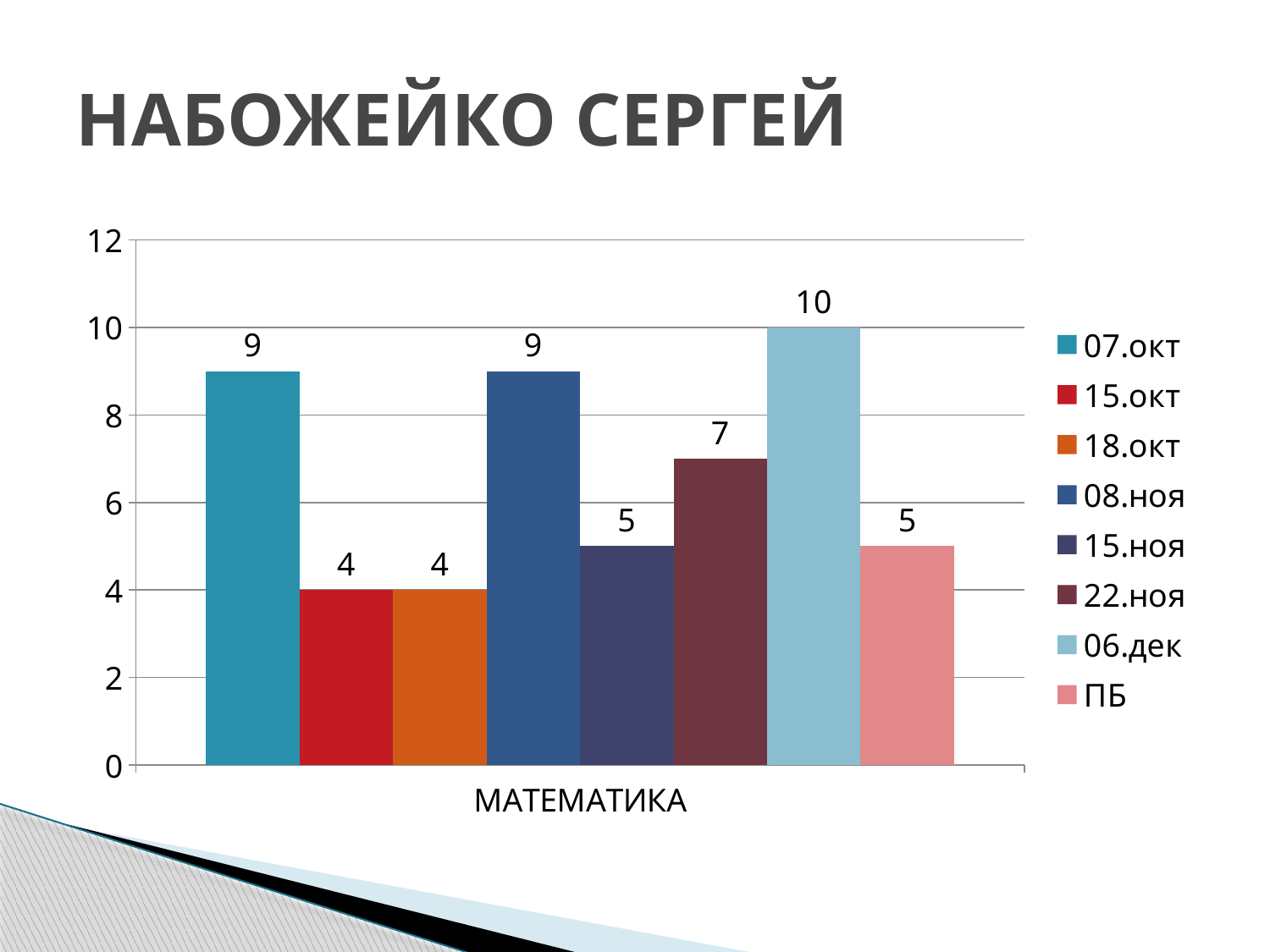
What is the difference between the 06.дек value and the 15.окт value? 6 What is the title of the slide? НАБОЖЕЙКО СЕРГЕЙ Which is larger, the value for 08.ноя or the value for 15.ноя? 08.ноя How many series does the legend list? 8 What is the value for the 22.ноя series? 7 Is the value for 22.ноя greater or less than 6? greater What is the value for the 07.окт series in the МАТЕМАТИКА category? 9 What is the value for the 06.дек series? 10 Which series has the highest value? 06.дек What is the category label shown on the x axis? МАТЕМАТИКА What is the value for the ПБ series? 5 What kind of chart is shown on the slide? bar chart